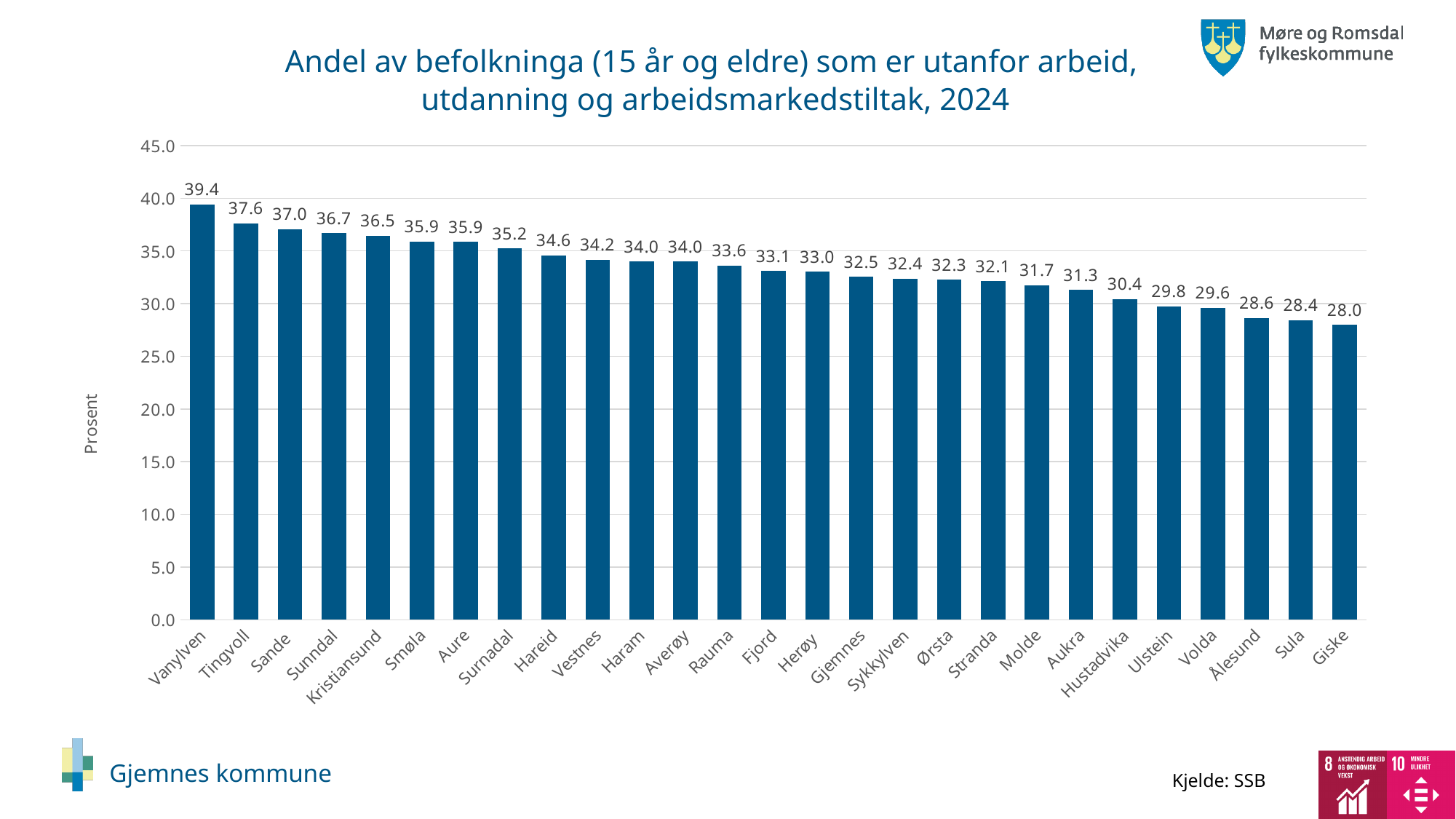
Which municipality has the lowest value? Giske Is the value for Hustadvika greater or less than 35.0? less Which has a larger value, Tingvoll or Ålesund? Tingvoll Which municipality has the highest value? Vanylven What is the difference between the values for Gjemnes and Molde? 0.8 What is the value for Kristiansund? 36.5 How many municipalities are shown in the chart? 27 What is the value for Gjemnes? 32.5 What is the difference between the values for Vanylven and Giske? 11.4 What kind of chart is shown on the slide? Bar chart What is the value for Molde? 31.7 What is the label of the vertical axis? Prosent